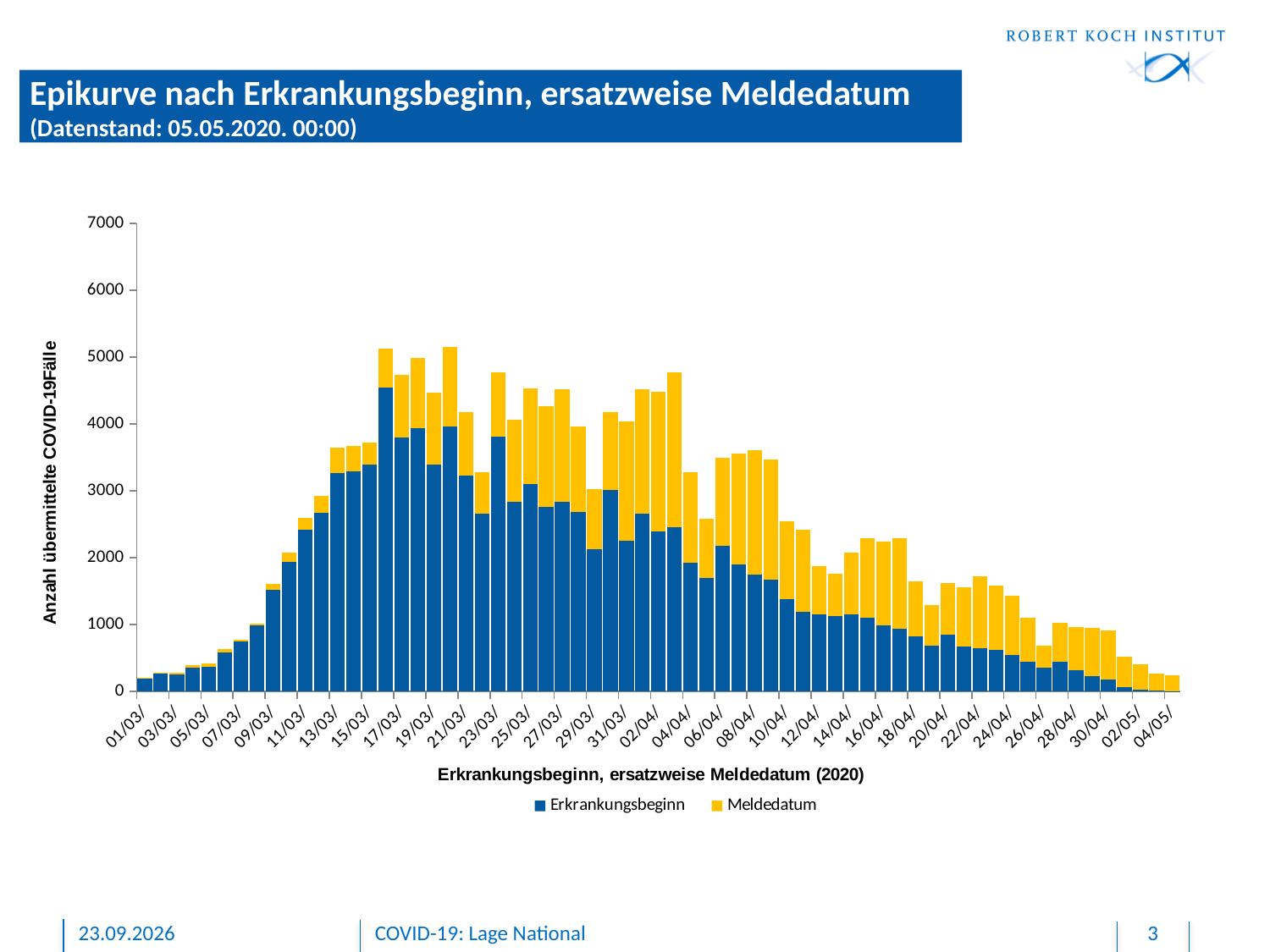
Is the total value of the bar for 01/03 greater or less than 1000? less Is the total value of the bar for 17/03 greater or less than 4000? greater Which two series are listed in the legend? Erkrankungsbeginn and Meldedatum Which bar has a larger total value, 17/03 or 01/03? 17/03 What kind of chart is shown on the slide? stacked bar chart Which bar has a larger total value, 04/04 or 24/04? 04/04 Is the total value of the bar for 12/04 greater or less than 3000? less What is the title of the y axis? Anzahl übermittelte COVID-19Fälle Do the bar totals generally rise or fall from 17/04 to 04/05? fall How many series does the legend list? 2